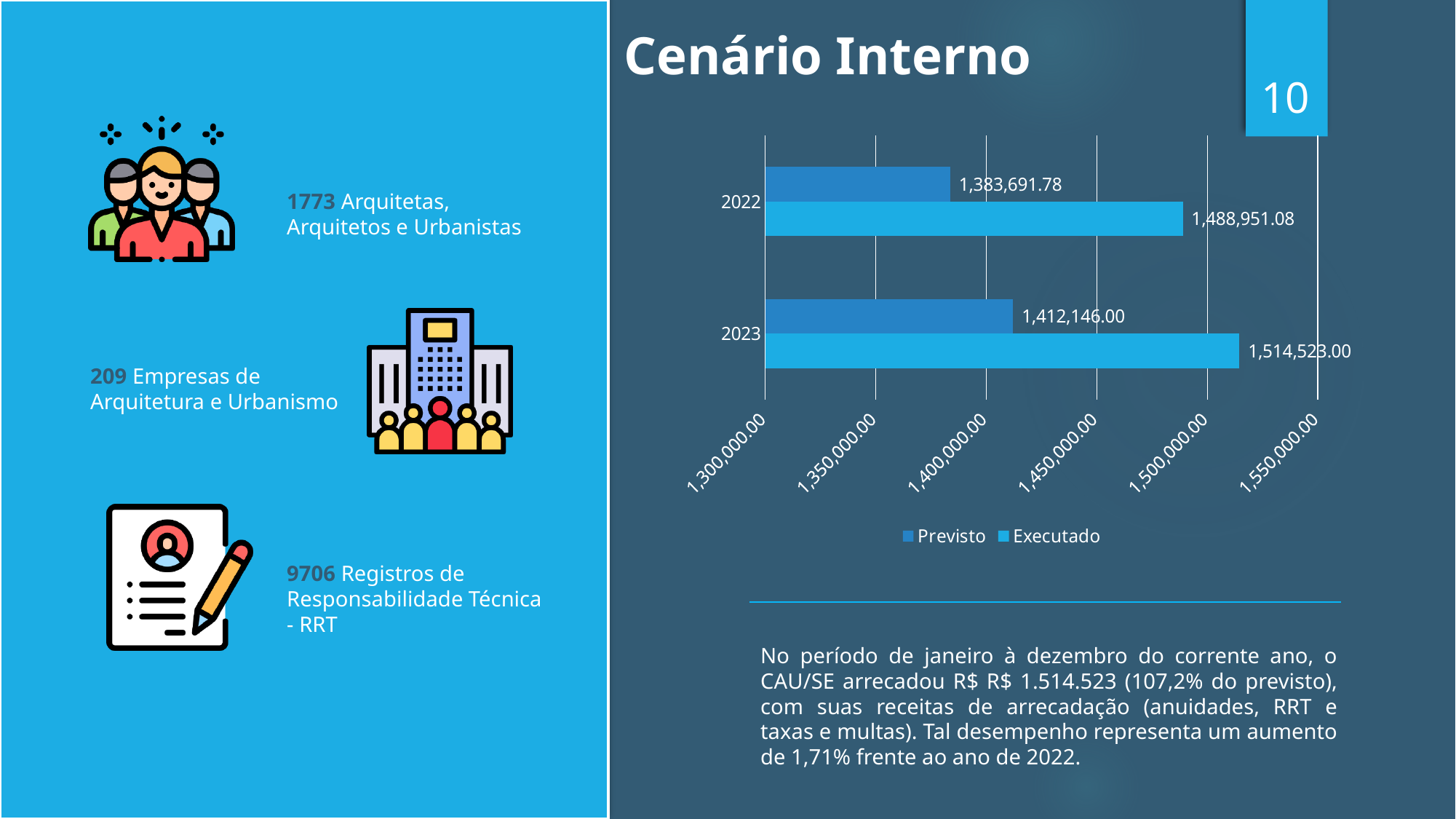
What is the difference between the Executado values for 2023 and 2022? 25,571.92 How many series does the chart legend list? 2 What is the Executado value for 2022? 1,488,951.08 Which year has the higher Executado value? 2023 Which bar in the chart has the lowest value? Previsto for 2022 What type of chart is shown on the slide? Bar chart Is the Previsto value for 2022 larger or smaller than the Previsto value for 2023? smaller What is the Executado value for 2023? 1,514,523.00 What is the difference between the Executado and Previsto values for 2023? 102,377.00 What is the Previsto value for 2022? 1,383,691.78 What is the Previsto value for 2023? 1,412,146.00 Is the Executado value for 2023 greater or less than 1,500,000.00? greater